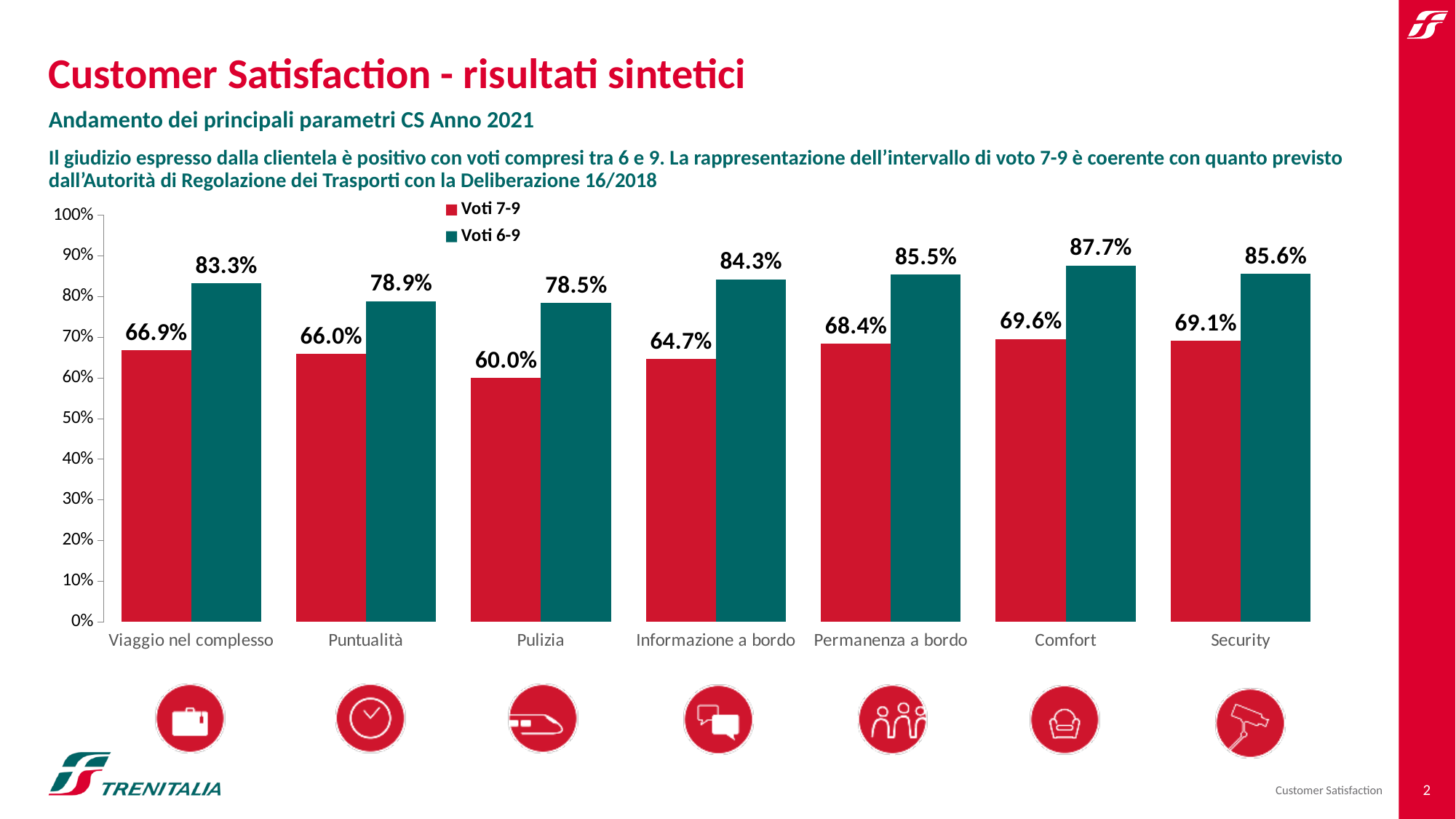
Is the Voti 6-9 value for Puntualità greater or less than 80%? less How many series does the legend list? 2 How many categories are shown on the x axis? 7 Which is larger: the Voti 7-9 value for Comfort or the Voti 7-9 value for Informazione a bordo? Comfort Which category has the lowest Voti 7-9 value? Pulizia What is the Voti 7-9 value for Viaggio nel complesso? 66.9% Which colour represents the Voti 6-9 series? teal (dark green) What kind of chart is shown on the slide? bar chart Which category has the highest Voti 6-9 value? Comfort What is the difference between the Voti 6-9 and Voti 7-9 values for Security? 16.5% What is the Voti 7-9 value for Pulizia? 60.0% What is the Voti 6-9 value for Comfort? 87.7%